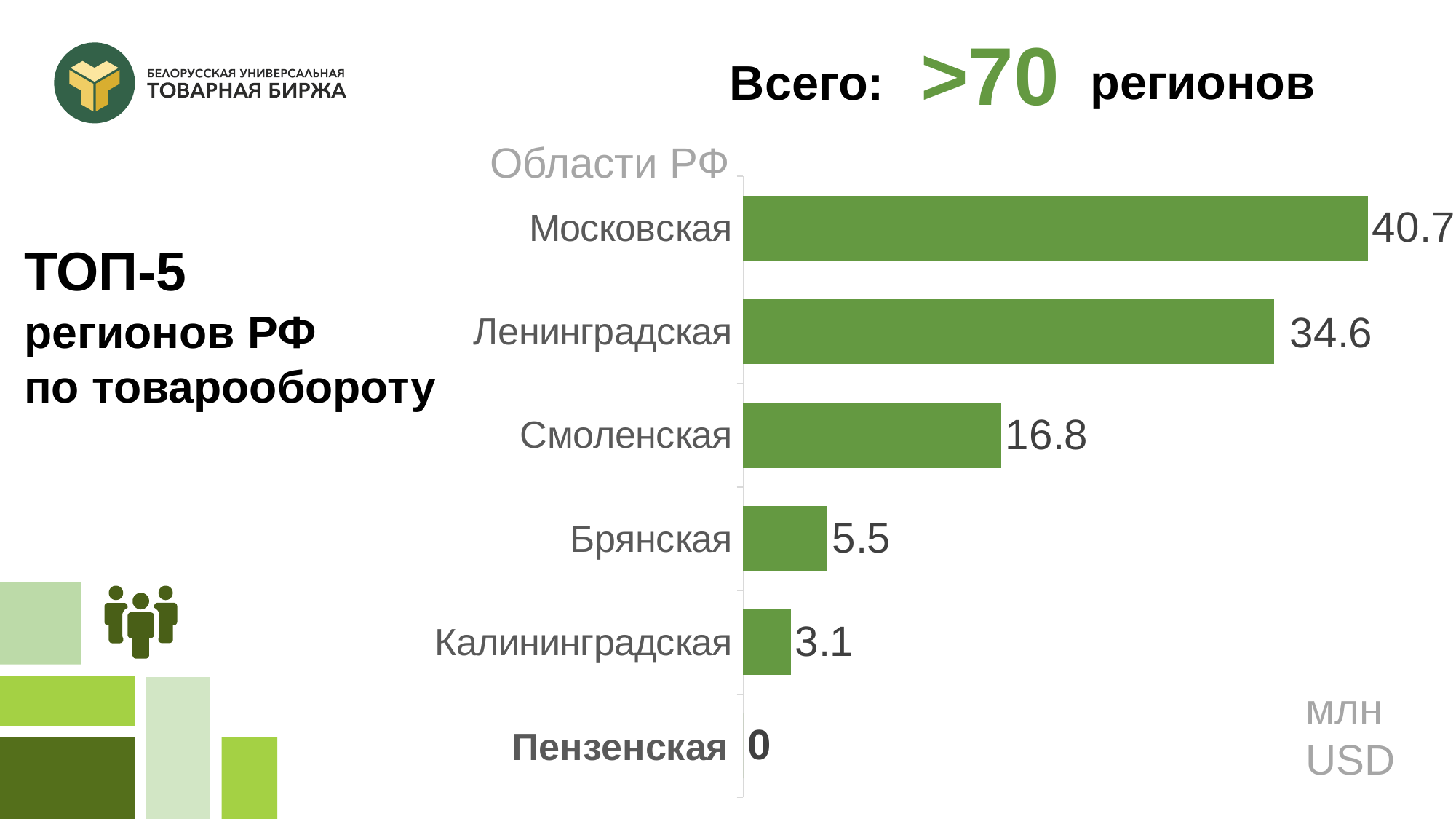
What is the value for Смоленская? 16.8 What is the difference between the values for Смоленская and Брянская? 11.3 What unit is indicated for the values on the chart? млн USD Which region has the lowest value? Пензенская Which region has the highest value? Московская How many regions are listed on the chart? 6 What is the value for Пензенская? 0 Which is larger, the value for Брянская or the value for Калининградская? Брянская What is the difference between the values for Московская and Ленинградская? 6.1 What kind of chart is shown on the slide? Bar chart What is the value for Московская? 40.7 What is the value for Калининградская? 3.1